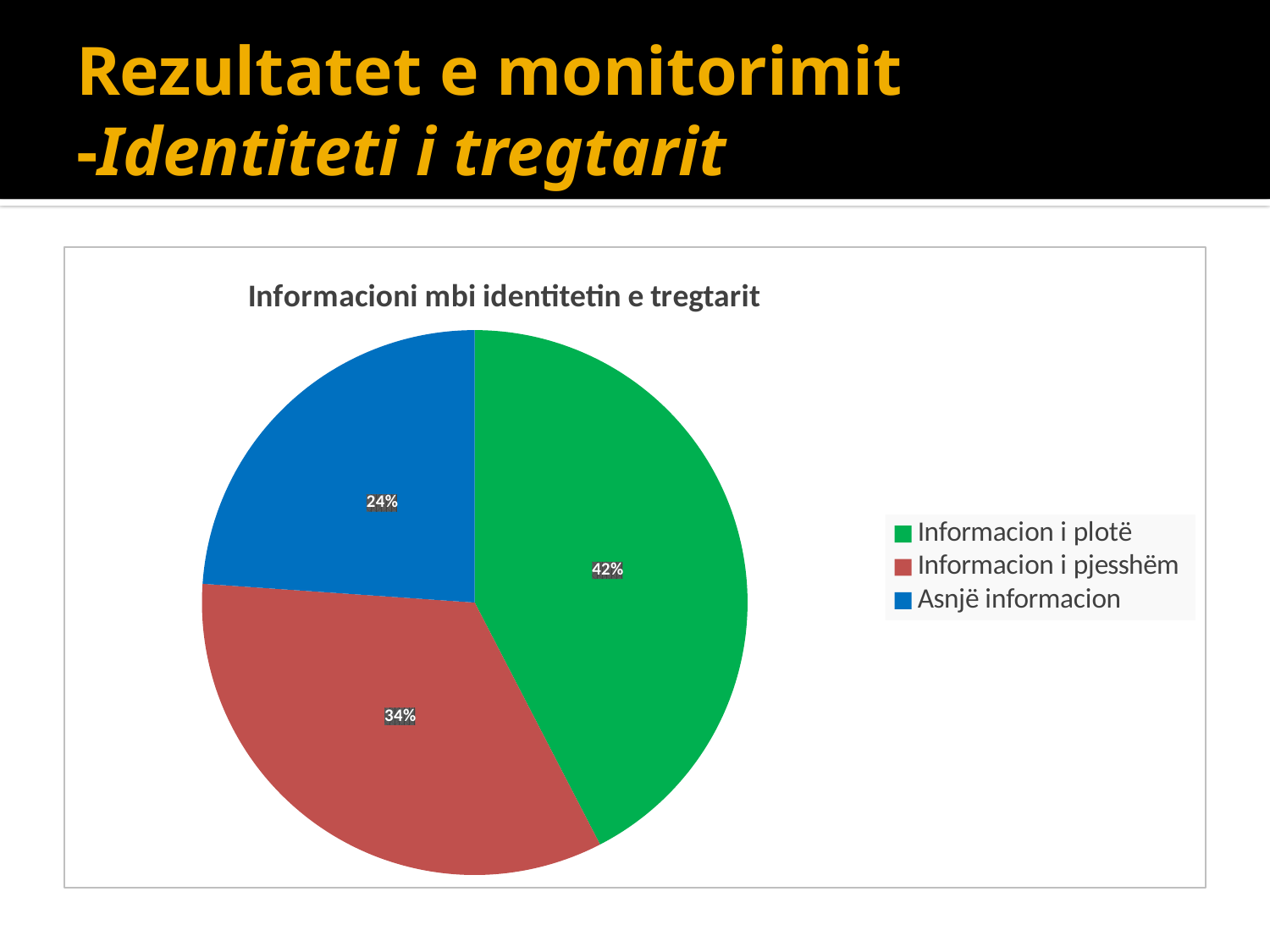
How many categories are shown in the pie chart? 3 Which is larger, the slice for "Informacion i pjesshëm" or the slice for "Asnjë informacion"? Informacion i pjesshëm What share of the pie does "Asnjë informacion" represent? 24% Which category has the smallest slice of the pie? Asnjë informacion What is the difference in percentage points between "Informacion i plotë" and "Asnjë informacion"? 18 What kind of chart is shown on the slide? Pie chart What is the difference in percentage points between "Informacion i pjesshëm" and "Asnjë informacion"? 10 What share of the pie does "Informacion i pjesshëm" represent? 34% Which category has the largest slice of the pie? Informacion i plotë What colour is the slice for "Asnjë informacion"? Blue What share of the pie does "Informacion i plotë" represent? 42% What is the title of the chart? Informacioni mbi identitetin e tregtarit